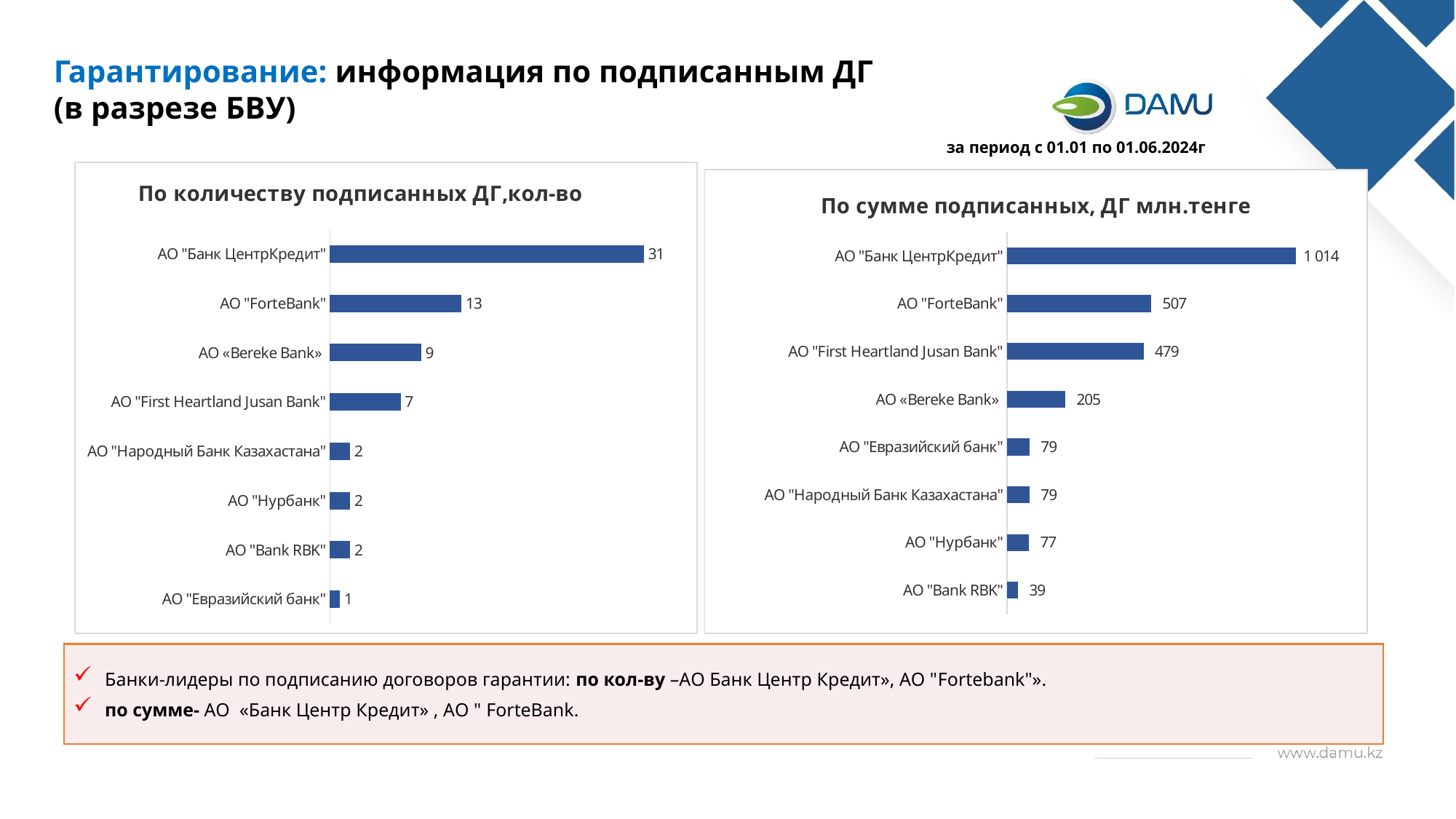
In the chart "По количеству подписанных ДГ,кол-во", which bank has the highest value? АО "Банк ЦентрКредит" In the chart "По сумме подписанных, ДГ млн.тенге", which bank has the lowest value? АО "Bank RBK" What type of chart is "По сумме подписанных, ДГ млн.тенге"? Bar chart How many banks are shown in the chart "По количеству подписанных ДГ,кол-во"? 8 In the chart "По количеству подписанных ДГ,кол-во", which bank has the lowest value? АО "Евразийский банк" In the chart "По сумме подписанных, ДГ млн.тенге", what is the value for АО "Bank RBK"? 39 In the chart "По сумме подписанных, ДГ млн.тенге", what is the difference between АО "Банк ЦентрКредит" and АО "ForteBank"? 507 In the chart "По количеству подписанных ДГ,кол-во", what is the value for АО "ForteBank"? 13 In the chart "По сумме подписанных, ДГ млн.тенге", which is larger: АО «Bereke Bank» or АО "Нурбанк"? АО «Bereke Bank» In the chart "По количеству подписанных ДГ,кол-во", what is the difference between АО «Bereke Bank» and АО "First Heartland Jusan Bank"? 2 What is the title of the chart on the left side of the slide? По количеству подписанных ДГ,кол-во In the chart "По сумме подписанных, ДГ млн.тенге", what is the value for АО "First Heartland Jusan Bank"? 479